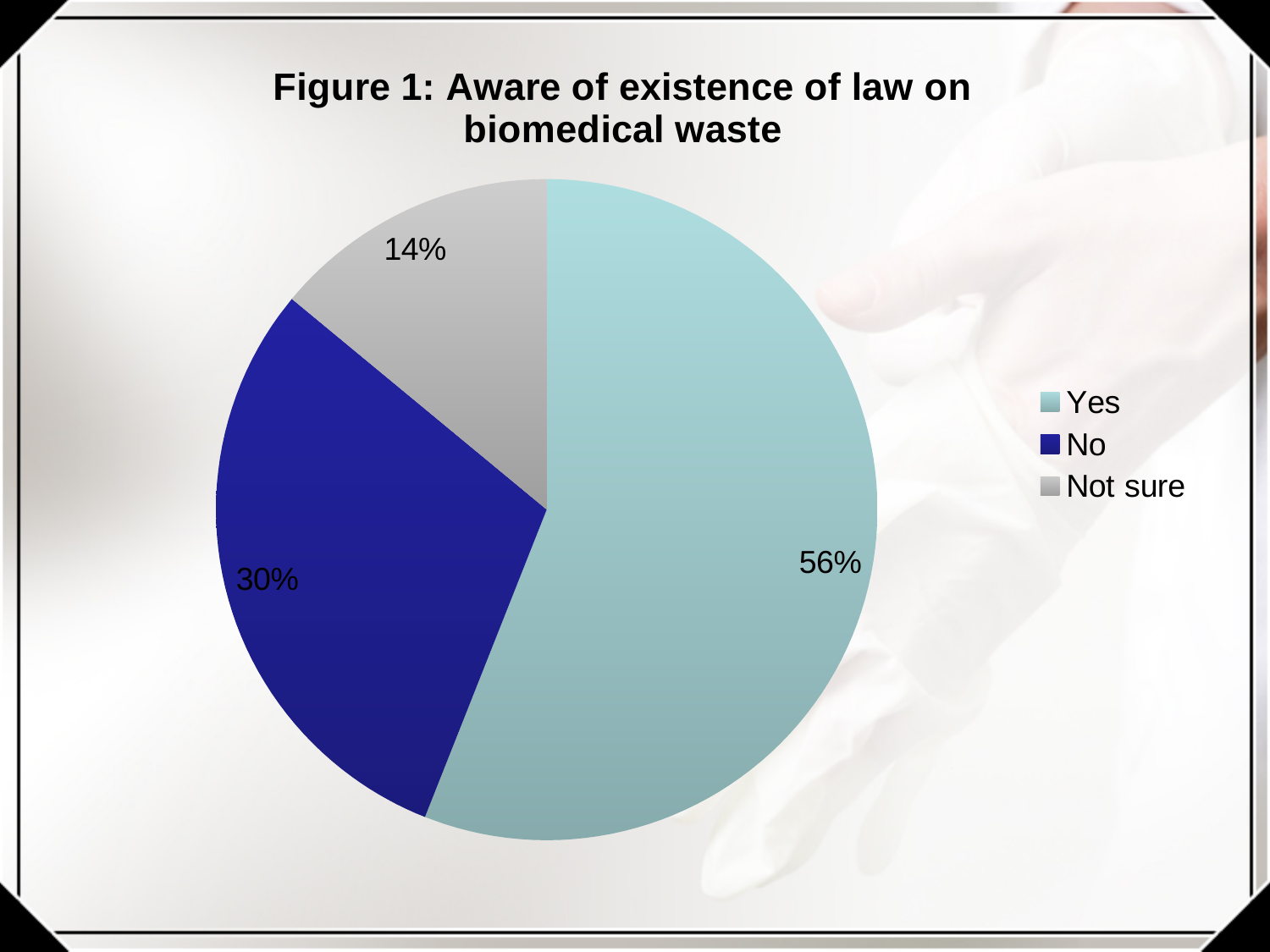
What percentage of respondents answered 'Yes'? 56% Which response has the smallest share of the pie? Not sure What percentage of respondents answered 'No'? 30% What kind of chart is shown on the slide? Pie chart What is the difference in percentage points between 'No' and 'Not sure'? 16 Which is larger, the share for 'No' or the share for 'Not sure'? No How many categories does the pie chart show? 3 Which response has the largest share of the pie? Yes Which colour represents 'No' in the legend? Dark blue What is the difference in percentage points between 'Yes' and 'No'? 26 What percentage of respondents answered 'Not sure'? 14% What is the title of the chart? Figure 1: Aware of existence of law on biomedical waste